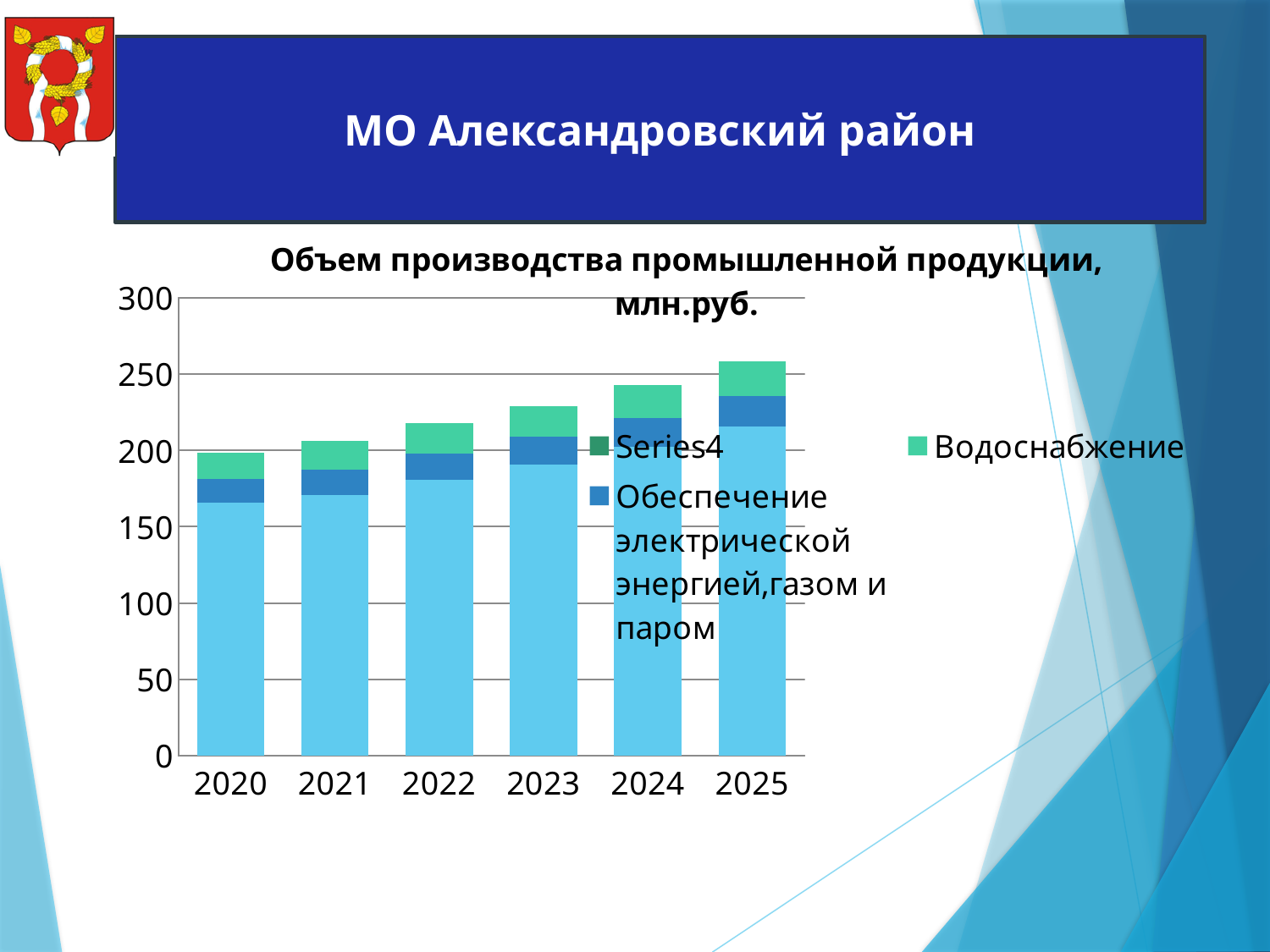
What is the title of the chart? Объем производства промышленной продукции, млн.руб. How many entries does the chart legend list? 3 Is the total bar height for 2022 greater or less than 200? greater Do the total bar heights rise or fall from 2020 to 2025? rise What kind of chart is shown on the slide? stacked bar chart Which year has the tallest stacked bar in the chart? 2025 Which year has the shortest stacked bar in the chart? 2020 Is the total bar height for 2023 greater or less than 250? less Which year has a taller stacked bar, 2021 or 2024? 2024 How many years are shown on the x axis of the chart? 6 Is the total bar height for 2025 greater or less than 250? greater